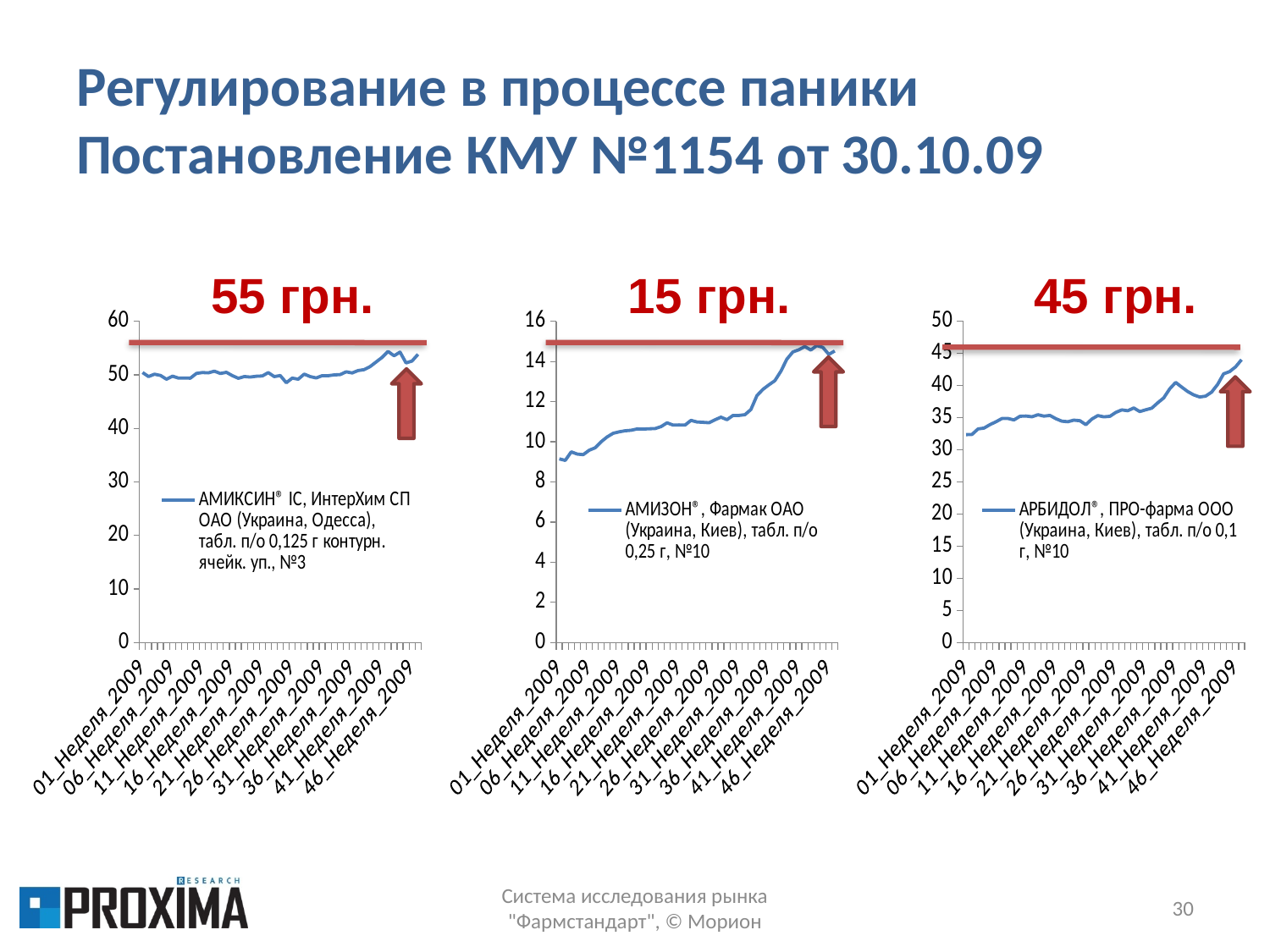
In the middle chart (АМИЗОН), which is larger: the value at 01_Неделя_2009 or the value at 46_Неделя_2009? 46_Неделя_2009 How many series does the legend of the middle chart (АМИЗОН) list? 1 What kind of chart is the left chart (АМИКСИН)? line chart What price level is written above the red line on the right chart (АРБИДОЛ)? 45 грн. In the middle chart (АМИЗОН), do the values generally rise or fall from 01_Неделя_2009 to 46_Неделя_2009? rise In the left chart (АМИКСИН), is the value at 01_Неделя_2009 greater or less than 40? greater In the right chart (АРБИДОЛ), is the value at 46_Неделя_2009 greater or less than 40? greater In the right chart (АРБИДОЛ), do the values generally rise or fall along the x axis? rise In the middle chart (АМИЗОН), is the value at 01_Неделя_2009 greater or less than 10? less What price level is written above the red line on the left chart (АМИКСИН)? 55 грн.